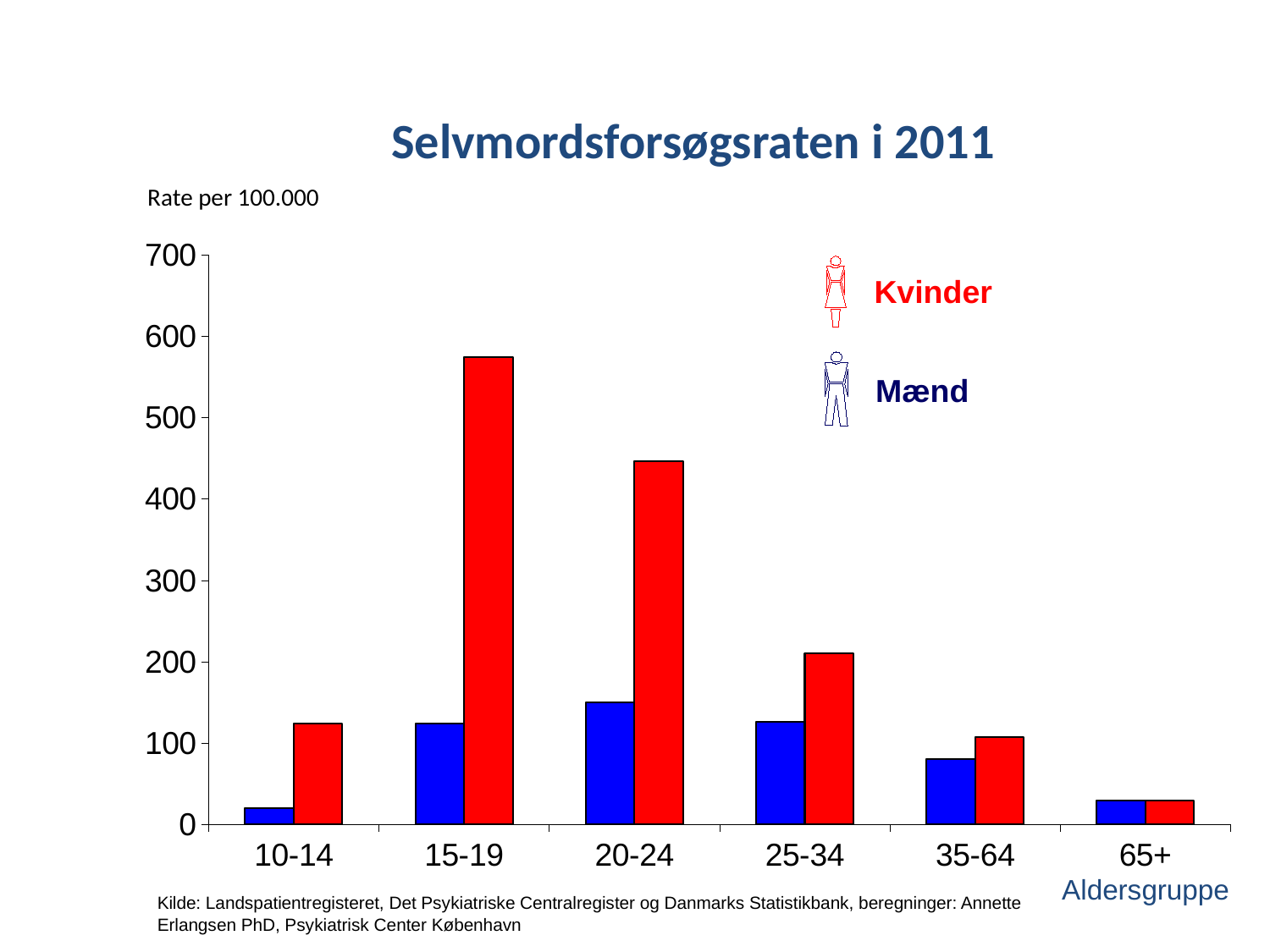
Which age group has the highest rate for Mænd? 20-24 What kind of chart is shown on the slide? bar chart Is the value for Mænd in the 35-64 age group greater or less than 100? less Which age group has the lowest rate for Kvinder? 65+ In the 25-34 age group, which series has the larger value, Kvinder or Mænd? Kvinder Is the value for Kvinder in the 20-24 age group greater or less than 400? greater What is the title of the chart? Selvmordsforsøgsraten i 2011 How many age groups are shown on the x axis? 6 Which age group has the lowest rate for Mænd? 10-14 Is the value for Kvinder in the 15-19 age group greater or less than 500? greater How many series does the legend list? 2 Which age group has the highest rate for Kvinder? 15-19